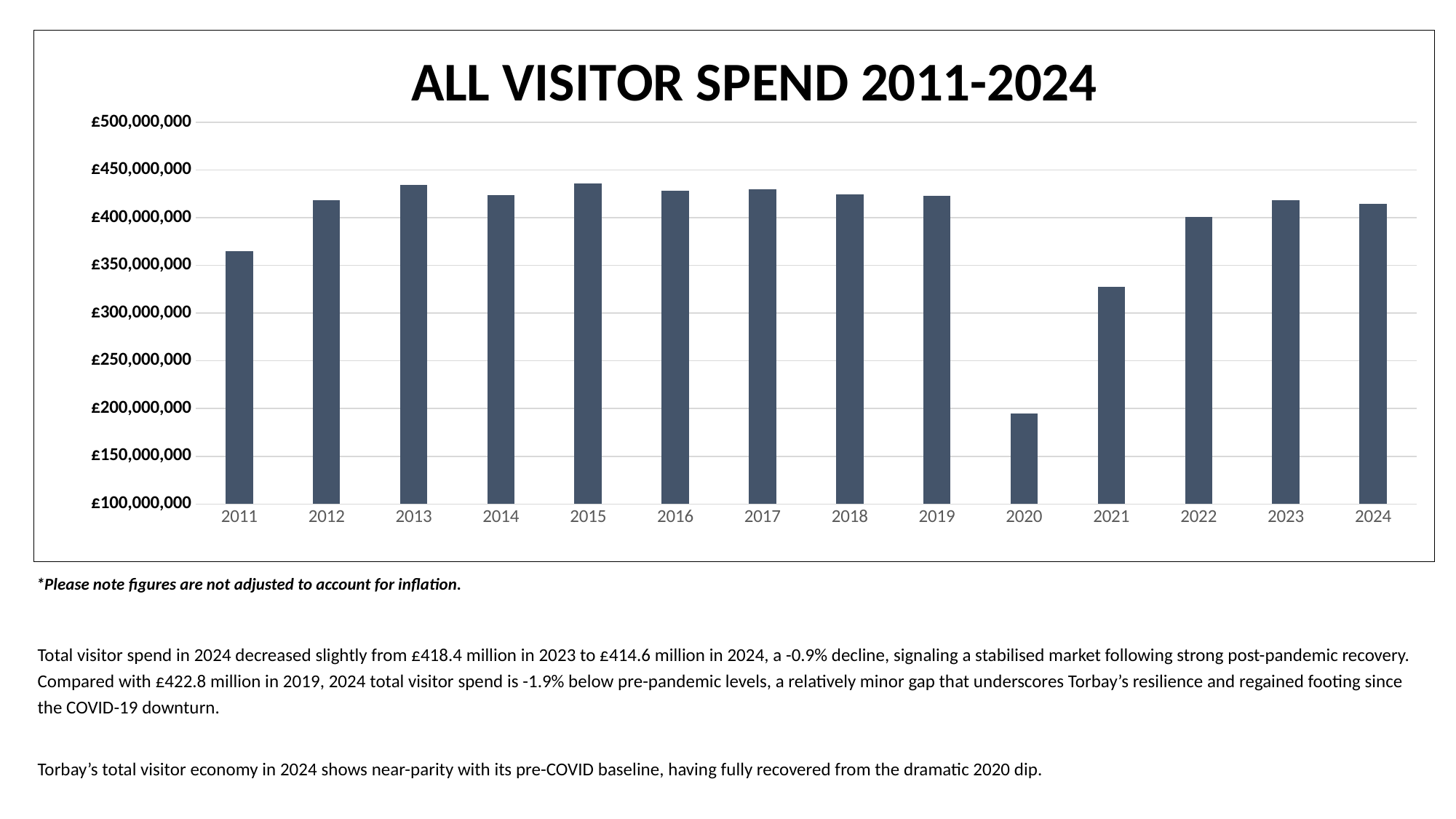
Is the value for 2013 greater or less than £450,000,000? less Is the value for 2020 greater or less than £200,000,000? less Which year has the higher visitor spend, 2011 or 2012? 2012 Is the value for 2011 greater or less than £350,000,000? greater What is the title of the chart? ALL VISITOR SPEND 2011-2024 Which year has the lowest visitor spend? 2020 Does visitor spend rise or fall from 2020 to 2023? rise Which year has the higher visitor spend, 2020 or 2021? 2021 Does visitor spend rise or fall from 2019 to 2020? fall How many years (bars) are plotted in the chart? 14 What kind of chart is shown on the slide? bar chart